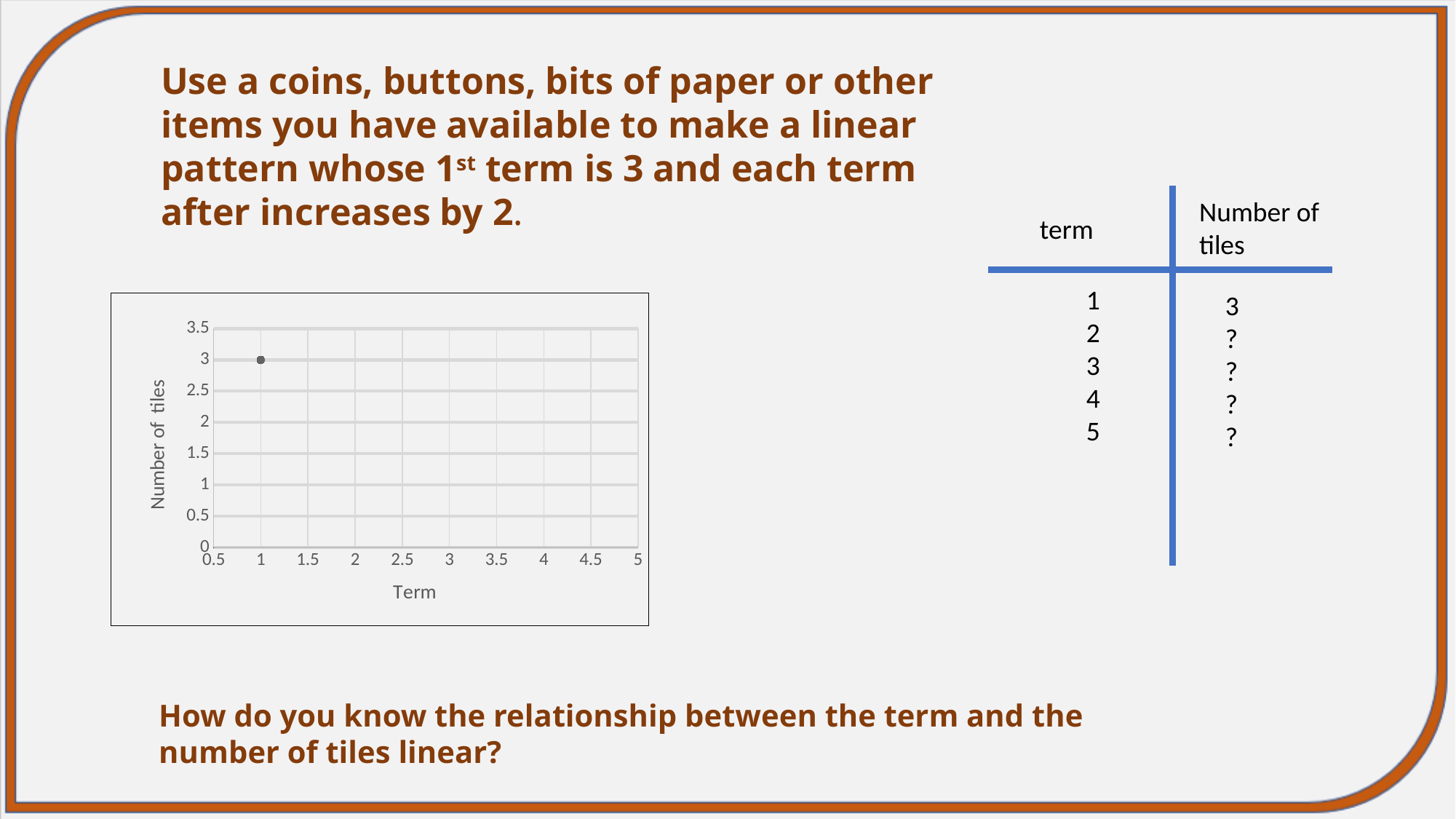
At which term value is the single data point plotted? 1 What kind of chart is shown on the slide? scatter chart How many data points are plotted on the chart? 1 What is the highest tick value shown on the x axis of the chart? 5 Is the plotted value for term 1 greater or less than 3.5? less Is the plotted value for term 1 greater or less than 2.5? greater What is the label of the x axis on the chart? Term What is the number of tiles plotted for term 1 on the chart? 3 What is the label of the y axis on the chart? Number of tiles What is the highest tick value shown on the y axis of the chart? 3.5